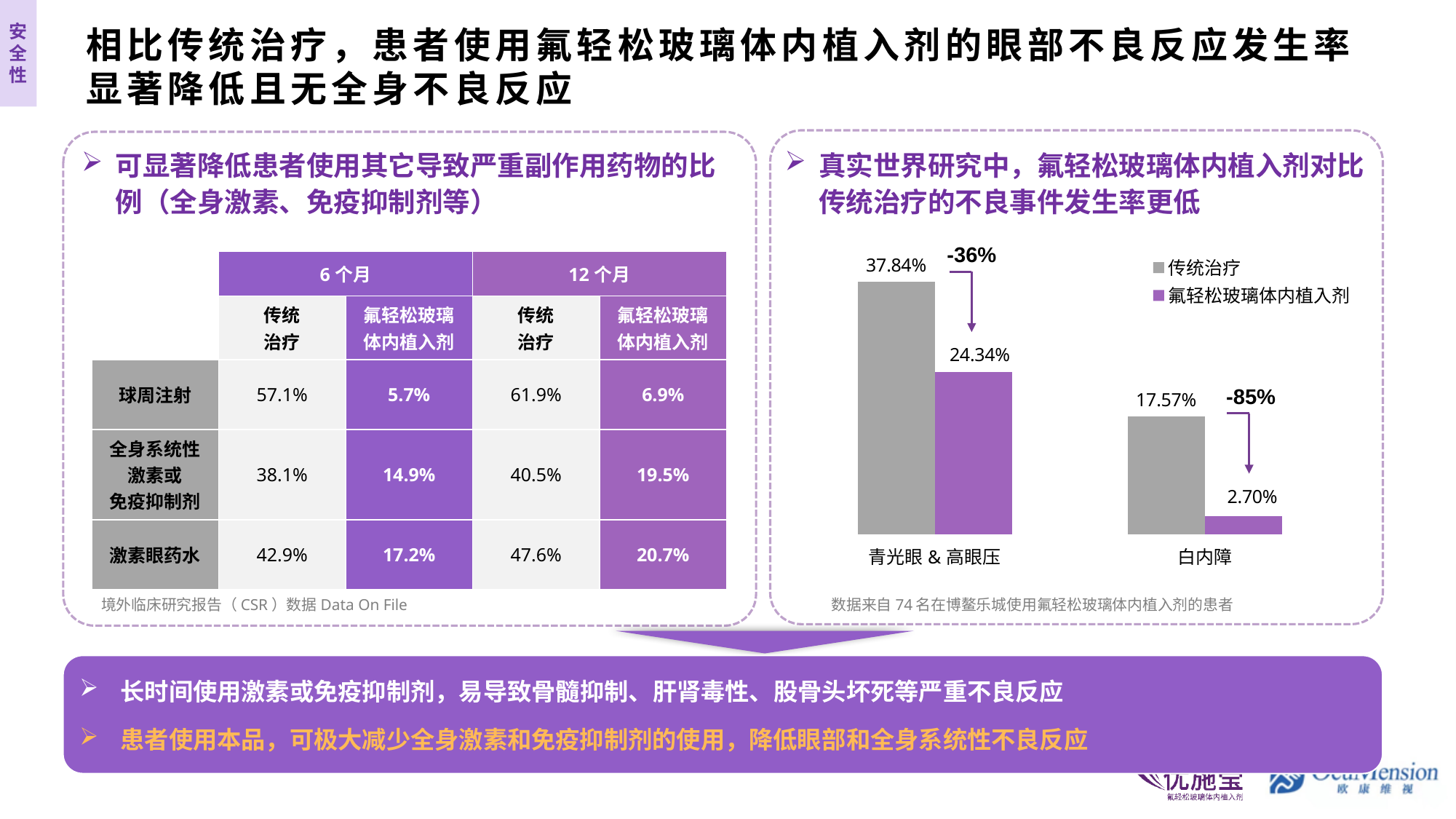
In the bar chart, what is the difference between 传统治疗 and 氟轻松玻璃体内植入剂 in the 白内障 category? 14.87% In the bar chart, what is the value for 氟轻松玻璃体内植入剂 in the 青光眼 & 高眼压 category? 24.34% In the bar chart, what is the value for 传统治疗 in the 白内障 category? 17.57% In the bar chart, which is larger for 青光眼 & 高眼压: 传统治疗 or 氟轻松玻璃体内植入剂? 传统治疗 In the bar chart, which bar has the highest value? 传统治疗, 青光眼 & 高眼压 In the bar chart, what is the value for 氟轻松玻璃体内植入剂 in the 白内障 category? 2.70% In the bar chart, what percentage reduction is annotated above the 白内障 bars? -85% How many categories are shown on the x axis of the bar chart? 2 In the bar chart, which bar has the lowest value? 氟轻松玻璃体内植入剂, 白内障 What type of chart is shown on the right side of the slide? bar chart In the bar chart, what is the value for 传统治疗 in the 青光眼 & 高眼压 category? 37.84% How many series does the legend of the bar chart list? 2